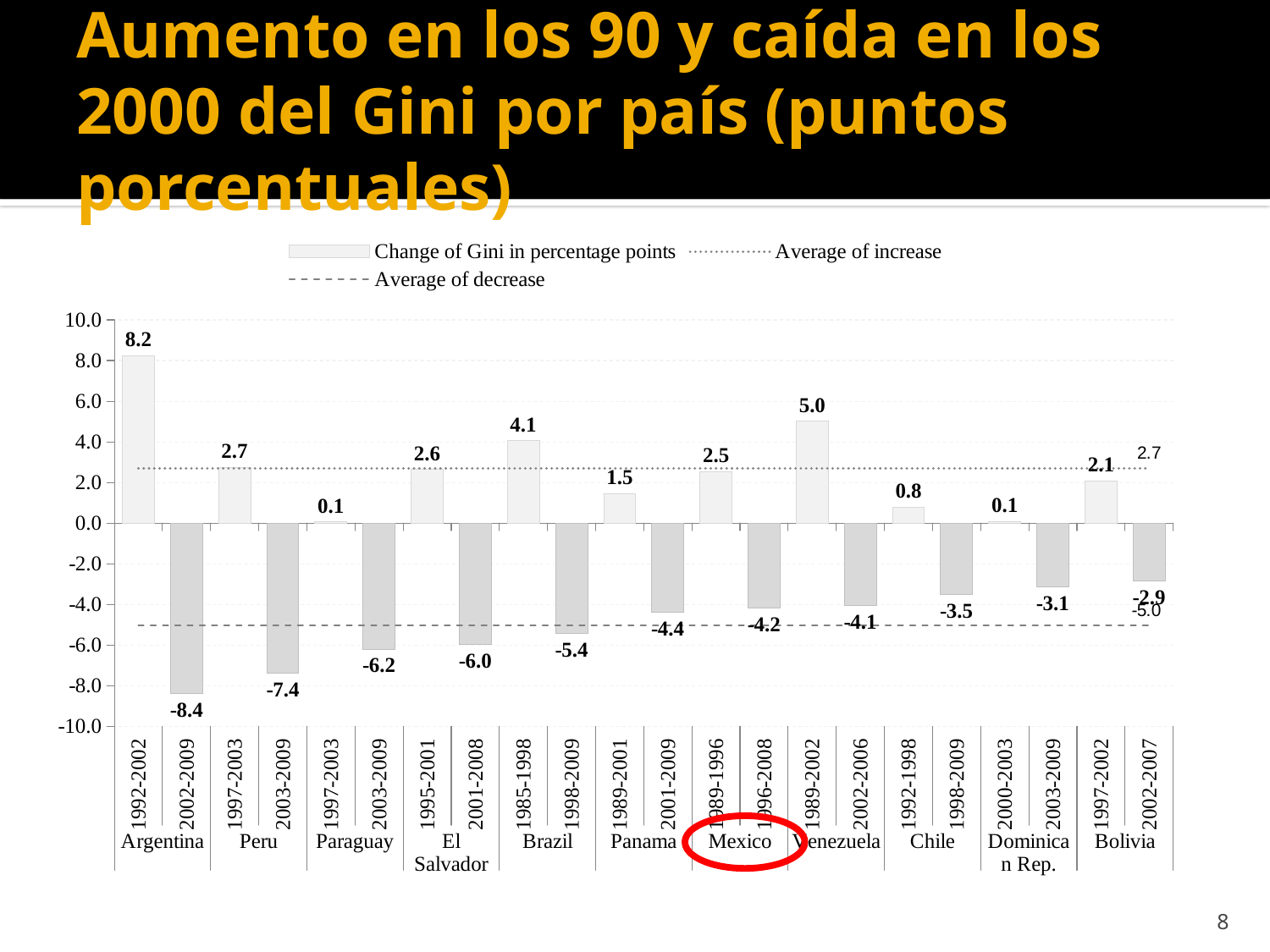
How many bars are plotted in the chart? 22 What is the change of Gini in percentage points for Venezuela in 1989-2002? 5.0 What is the change of Gini in percentage points for Mexico in 1996-2008? -4.2 How many series does the legend list? 3 What is the change of Gini in percentage points for Argentina in 1992-2002? 8.2 Which is larger, the change of Gini for Peru in 1997-2003 or for El Salvador in 1995-2001? Peru 1997-2003 What kind of chart is shown on the slide? Bar chart Which country label is circled in red on the chart? Mexico What is the difference between the change of Gini for Brazil in 1985-1998 and Brazil in 1998-2009? 9.5 Which country-period bar has the lowest change of Gini? Argentina 2002-2009 What value is shown for the average of increase line? 2.7 Which country-period bar has the highest change of Gini? Argentina 1992-2002